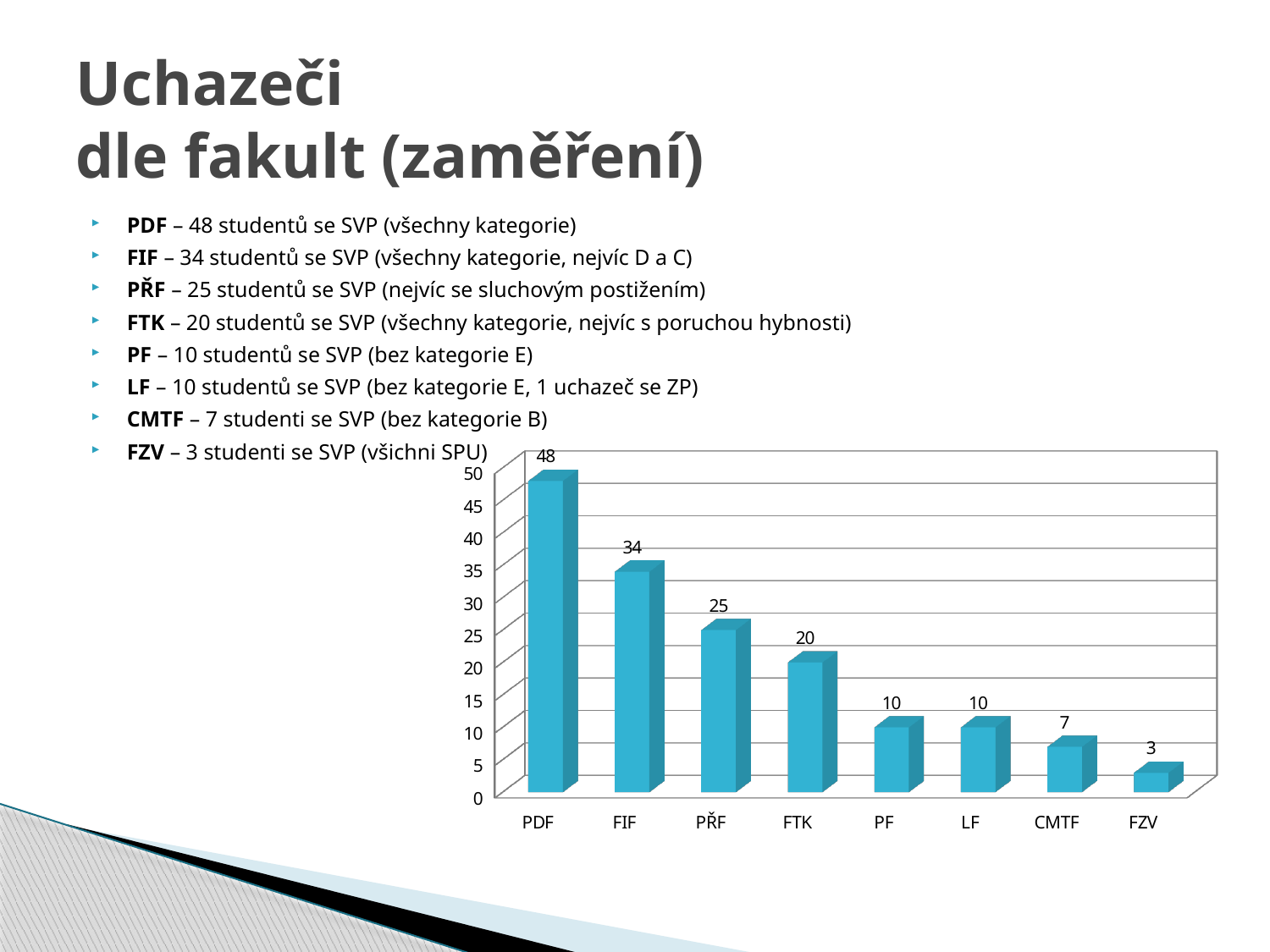
What is the value for CMTF? 7 Which is larger, the value for FIF or the value for PŘF? FIF What is the difference between the values for FTK and FZV? 17 What is the value for PDF? 48 Which category has the lowest value? FZV What is the difference between the values for PDF and FIF? 14 How many categories are shown on the x axis? 8 Is the value for FTK greater or less than 15? greater What kind of chart is this? bar chart Which category has the highest value? PDF What is the value for PŘF? 25 Do the values rise or fall from left to right along the x axis? fall